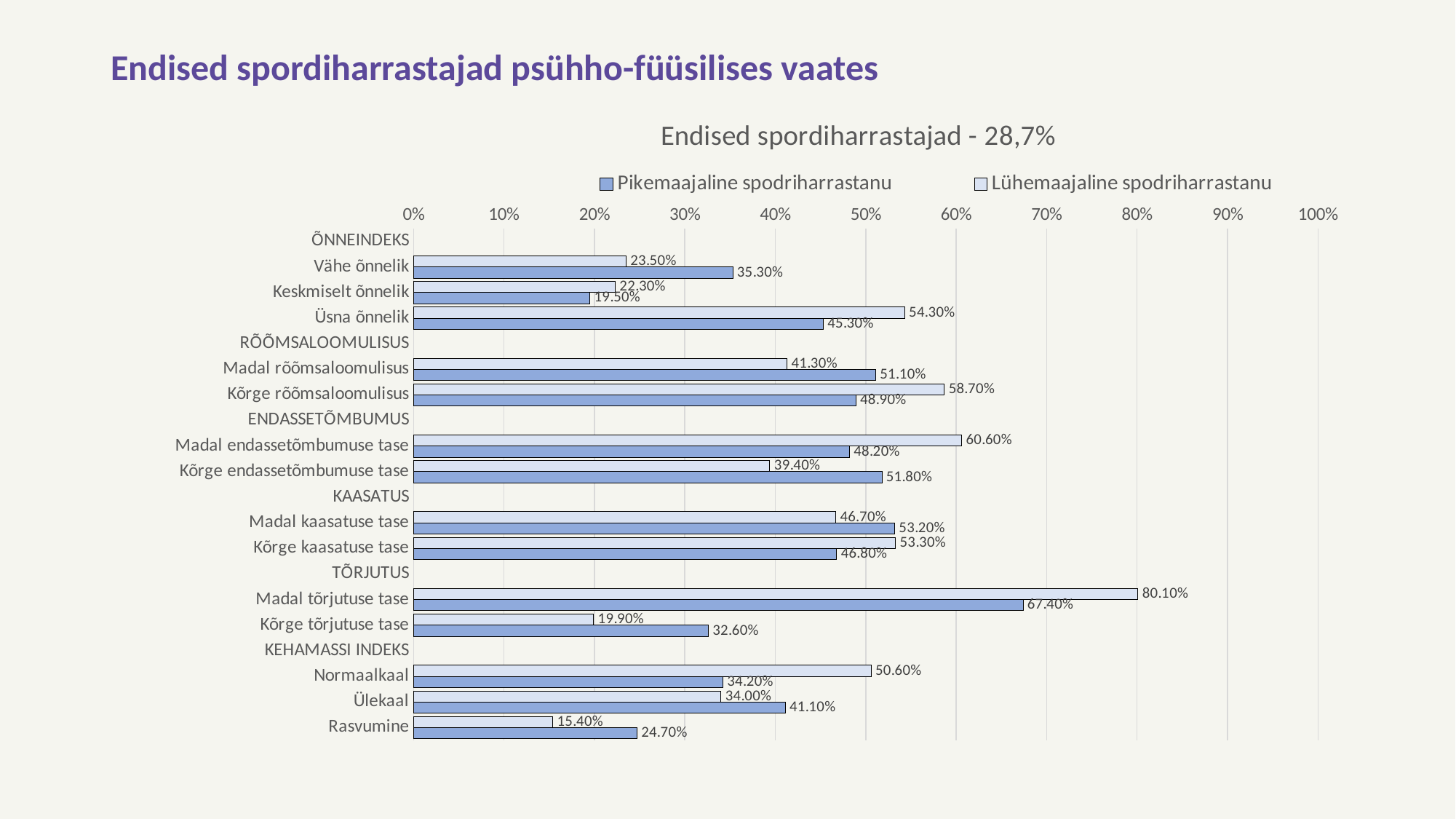
What is the value for Üsna õnnelik in the Lühemaajaline spodriharrastanu series? 54.30% Which category has the lowest value in the Lühemaajaline spodriharrastanu series? Rasvumine What is the value for Madal tõrjutuse tase in the Lühemaajaline spodriharrastanu series? 80.10% What type of chart is shown on the slide? bar chart What is the value for Rasvumine in the Pikemaajaline spodriharrastanu series? 24.70% For Kõrge endassetõmbumuse tase, which series has the larger value? Pikemaajaline spodriharrastanu Is the Pikemaajaline spodriharrastanu value for Kõrge tõrjutuse tase greater or less than 30%? greater What is the difference between the Lühemaajaline and Pikemaajaline values for Normaalkaal? 16.40% What is the title of the chart? Endised spordiharrastajad - 28,7% What is the difference between the Lühemaajaline and Pikemaajaline values for Madal tõrjutuse tase? 12.70% Which category has the highest value in the Pikemaajaline spodriharrastanu series? Madal tõrjutuse tase How many series does the legend list? 2